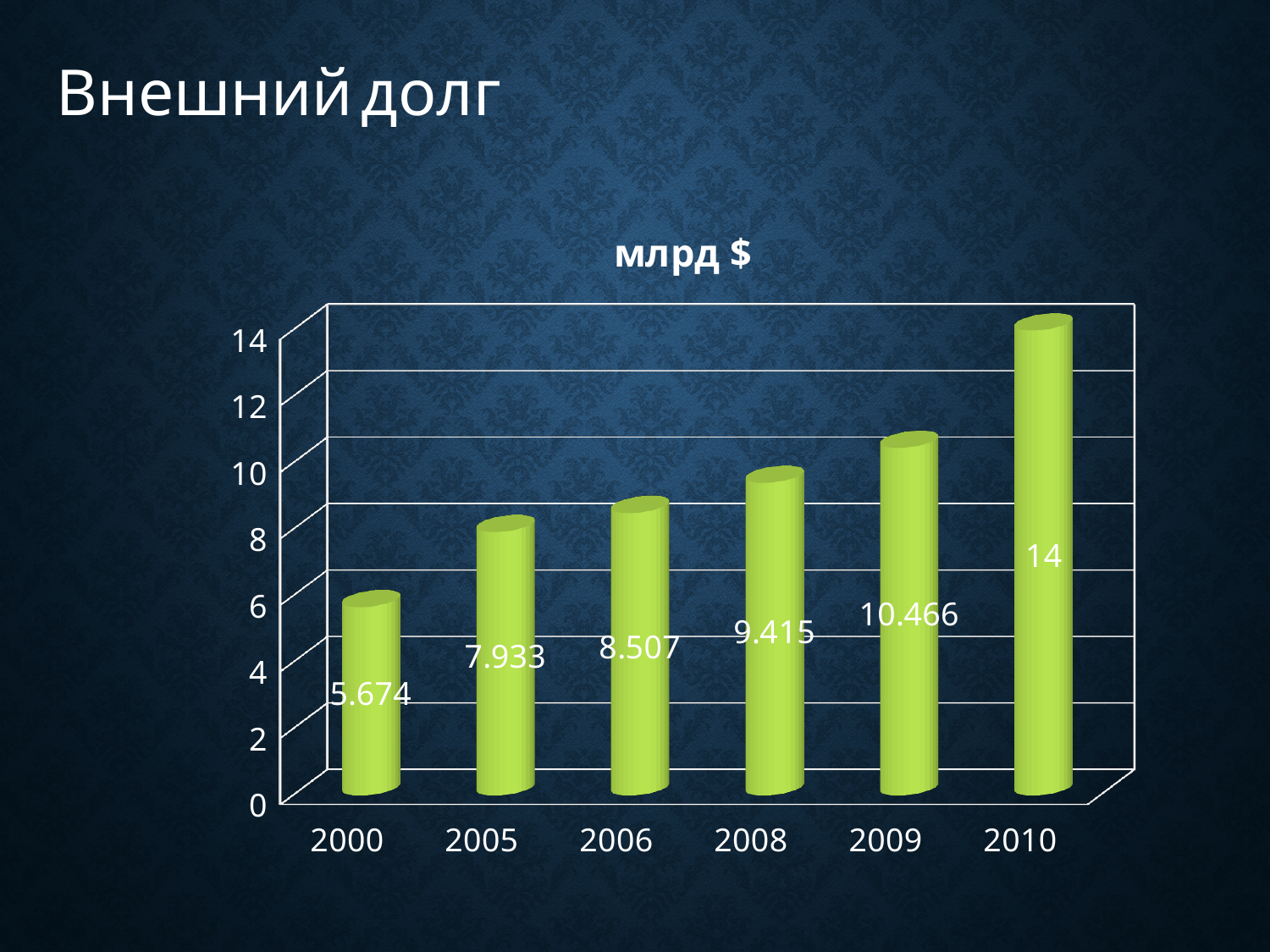
How many years are shown on the x axis? 6 What is the value for 2000? 5.674 What is the difference between the values for 2010 and 2009? 3.534 Which year has the highest value? 2010 Which year has the lowest value? 2000 What is the value for 2010? 14 What kind of chart is this? bar chart Is the value for 2009 greater or less than 10? greater What is the value for 2008? 9.415 Which is larger, the value for 2005 or the value for 2006? 2006 What is the title of the chart? млрд $ Do the values rise or fall from 2000 to 2010? rise